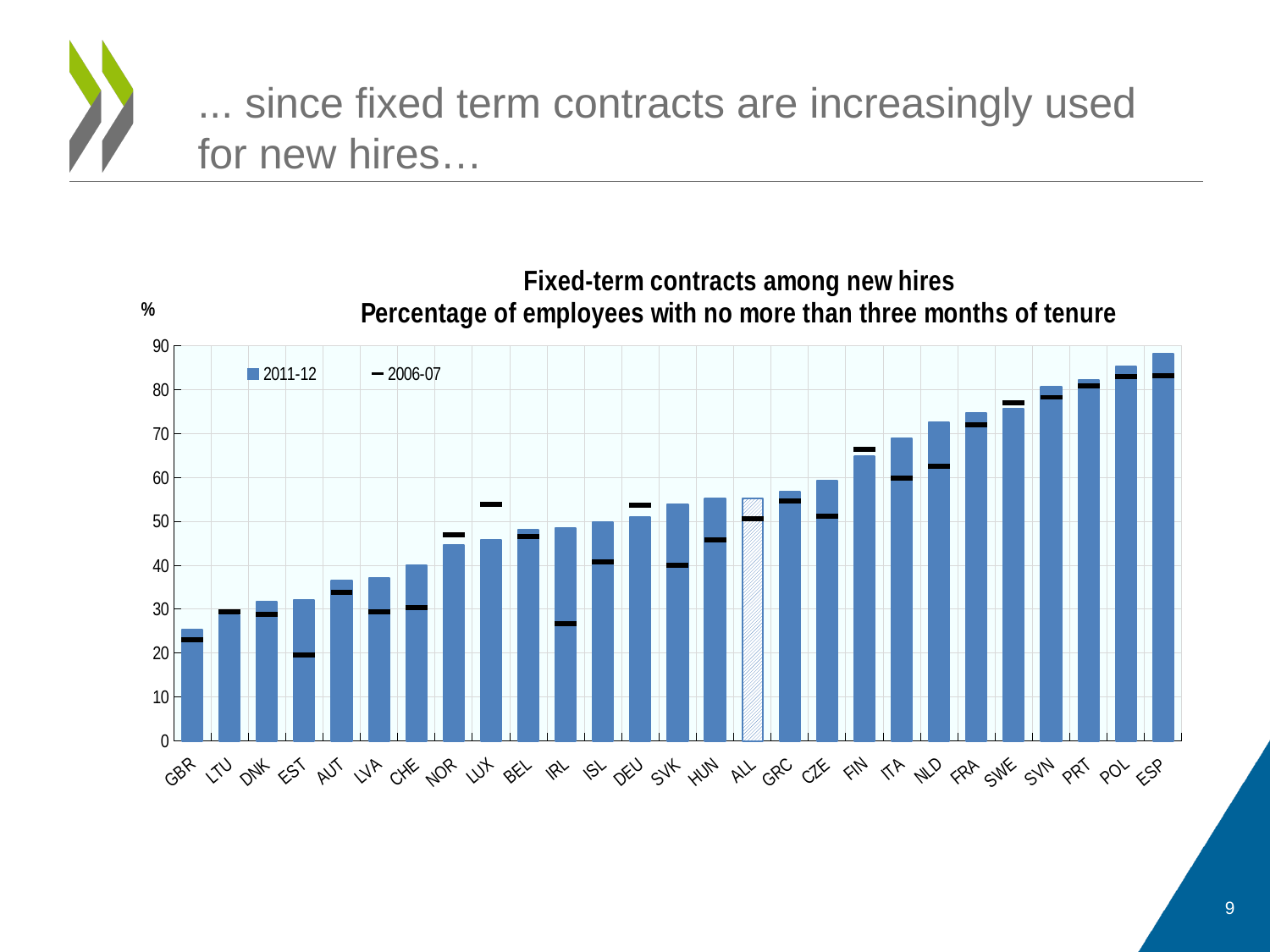
Which has a larger 2011-12 value, FRA or NOR? FRA Is the 2006-07 value for IRL greater or less than 30? less Which category has the lowest 2011-12 value? GBR Which category has the highest 2011-12 value? ESP How many countries/categories are shown on the x axis? 27 Is the 2011-12 value for GBR greater or less than 30? less What kind of chart is shown on the slide? bar chart Do the 2011-12 values generally rise or fall from left to right along the x axis? rise How many series does the legend list? 2 Is the 2011-12 value for ESP greater or less than 80? greater Which is larger for LUX: the 2011-12 value or the 2006-07 value? 2006-07